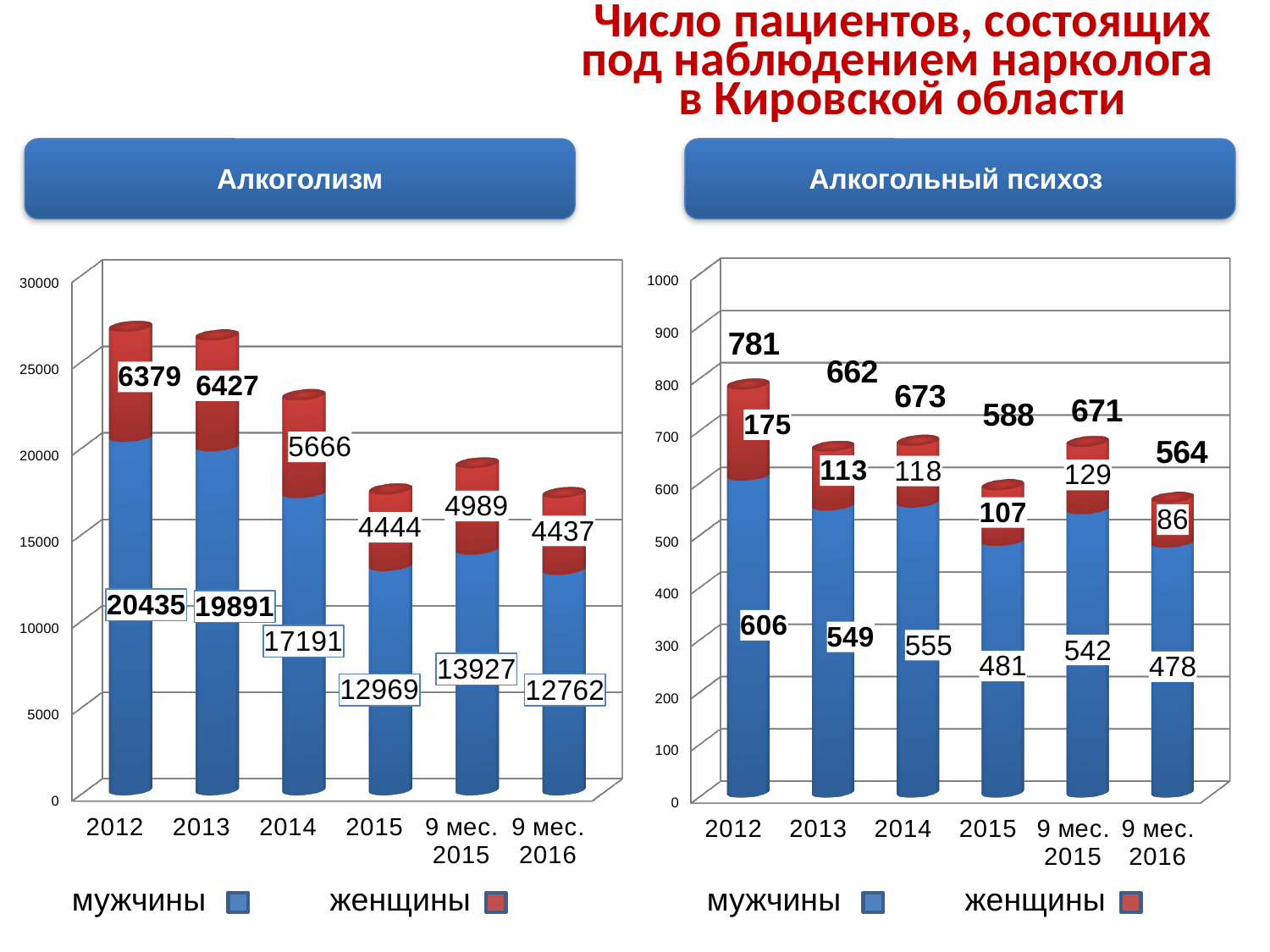
In the Алкоголизм chart, what is the difference between the мужчины values for 2012 and 2013? 544 In the Алкоголизм chart, what is the total of the stacked bar for 2015? 17413 In the Алкогольный психоз chart, is the value for мужчины in 2014 larger than in 2013? Yes In the Алкогольный психоз chart, what is the total shown above the bar for 2012? 781 What kind of chart is the Алкогольный психоз chart? Stacked bar chart In the Алкогольный психоз chart, what is the difference between the totals for 2014 and 2015? 85 In the Алкогольный психоз chart, what is the value for женщины in 9 мес. 2016? 86 In the Алкоголизм chart, what is the value for мужчины in 2012? 20435 In the Алкоголизм chart, which year has the lowest value for мужчины? 9 мес. 2016 In the Алкоголизм chart, what is the value for женщины in 2014? 5666 How many series does the legend of the Алкоголизм chart list? 2 In the Алкогольный психоз chart, which year has the highest value for женщины? 2012